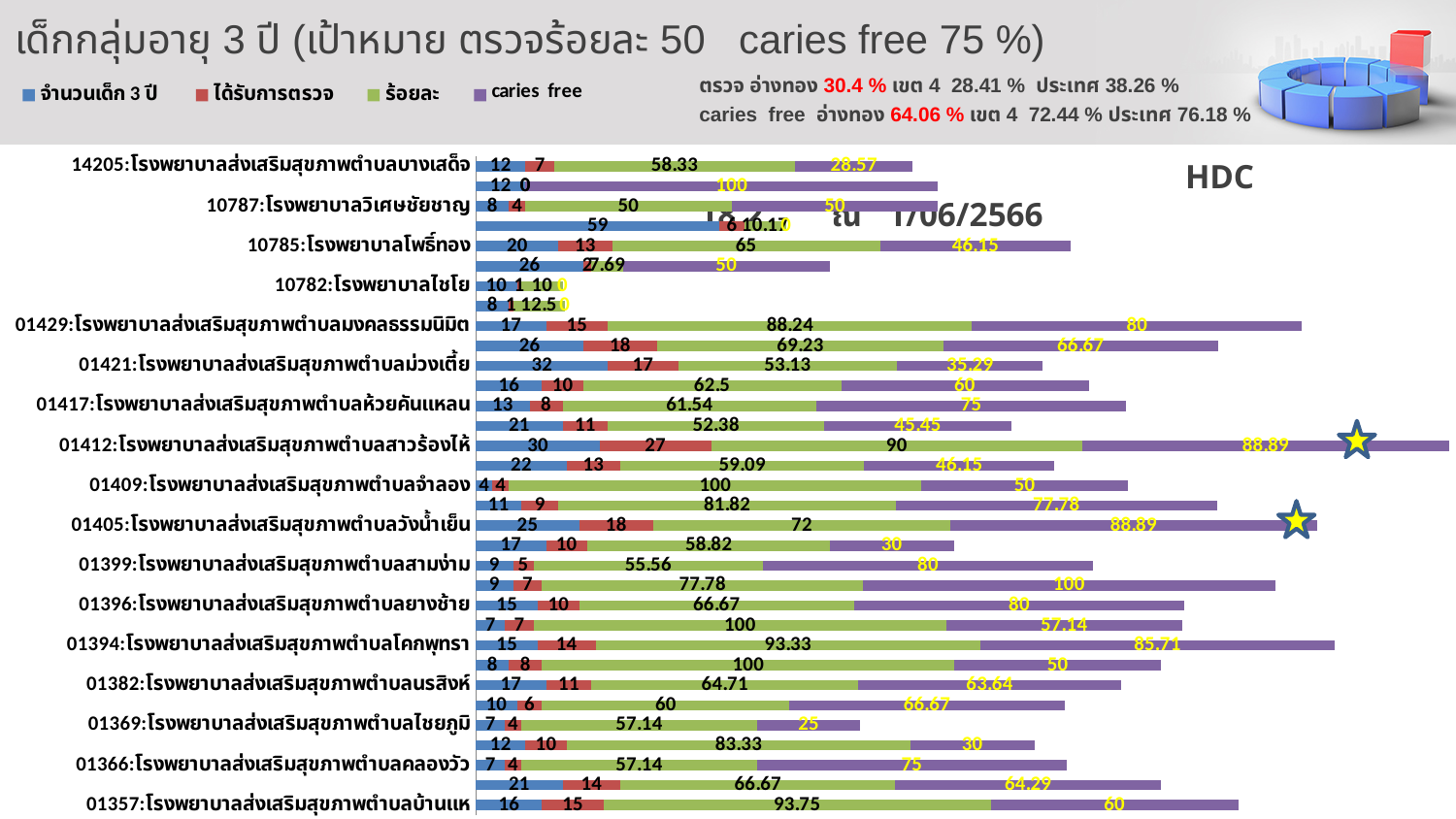
What is the ร้อยละ value for 10782:โรงพยาบาลไชโย? 10 According to the text at the top of the slide, what is the caries free percentage for อ่างทอง? 64.06 % What is the caries free value for 01405:โรงพยาบาลส่งเสริมสุขภาพตำบลวังน้ำเย็น? 88.89 What is the ได้รับการตรวจ value for 01357:โรงพยาบาลส่งเสริมสุขภาพตำบลบ้านแห? 15 What is the caries free value for 01369:โรงพยาบาลส่งเสริมสุขภาพตำบลไชยภูมิ? 25 What is the difference between the จำนวนเด็ก 3 ปี value and the ได้รับการตรวจ value for 10785:โรงพยาบาลโพธิ์ทอง? 7 Which has the larger ร้อยละ value, 01394:โรงพยาบาลส่งเสริมสุขภาพตำบลโคกพุทรา or 01382:โรงพยาบาลส่งเสริมสุขภาพตำบลนรสิงห์? 01394:โรงพยาบาลส่งเสริมสุขภาพตำบลโคกพุทรา What is the ร้อยละ value for 01412:โรงพยาบาลส่งเสริมสุขภาพตำบลสาวร้องไห้? 90 What kind of chart is shown on the slide? bar chart What is the จำนวนเด็ก 3 ปี value for 01421:โรงพยาบาลส่งเสริมสุขภาพตำบลม่วงเตี้ย? 32 Which series in the legend is shown in purple? caries free How many series does the chart legend list? 4